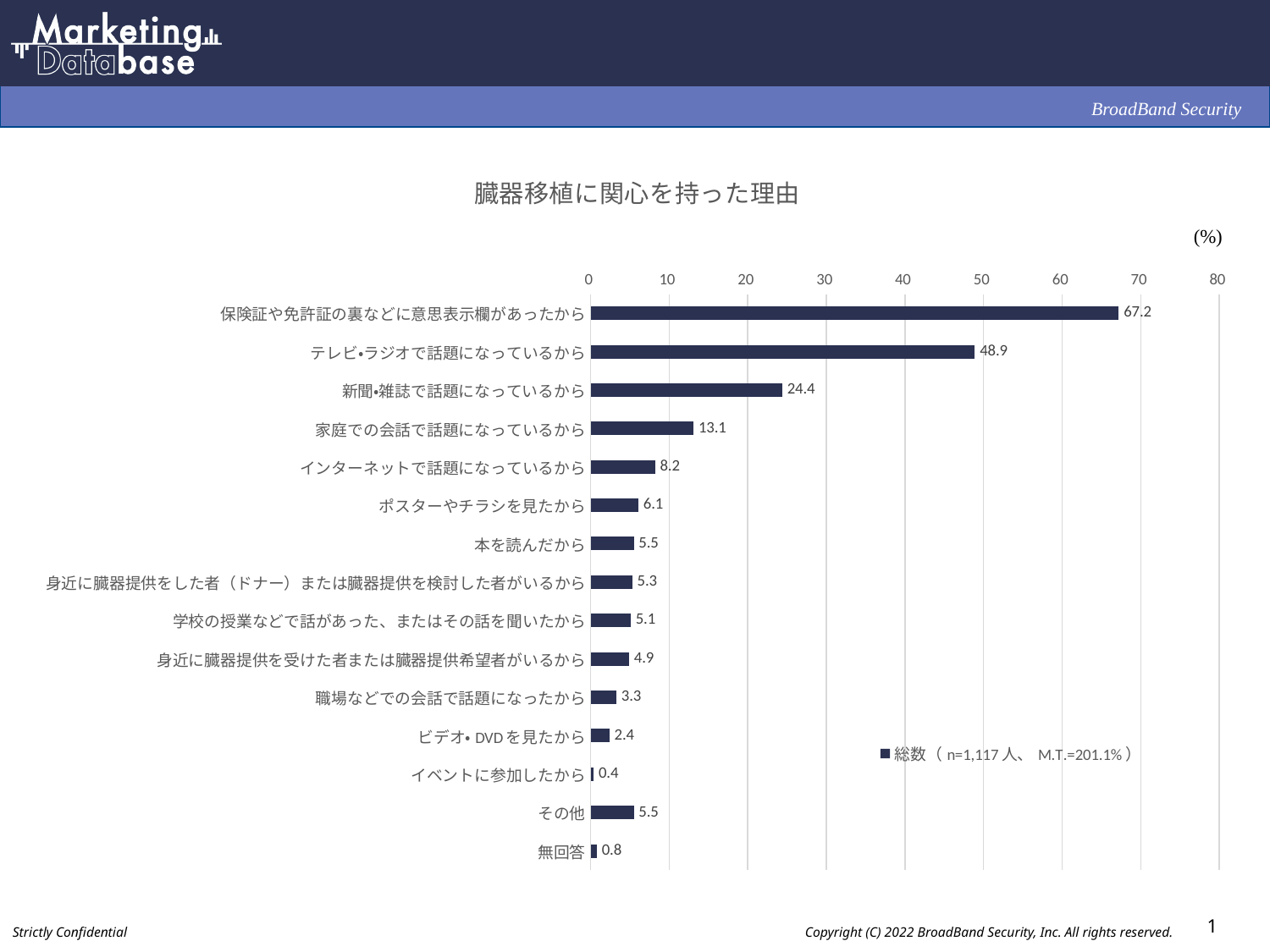
How many series does the legend list? 1 Which is larger, the value for 新聞•雑誌で話題になっているから or the value for 家庭での会話で話題になっているから? 新聞•雑誌で話題になっているから What is the value for 家庭での会話で話題になっているから? 13.1 What is the difference between the values for 保険証や免許証の裏などに意思表示欄があったから and テレビ•ラジオで話題になっているから? 18.3 What is the value for テレビ•ラジオで話題になっているから? 48.9 Which category has the lowest value? イベントに参加したから Is the value for テレビ•ラジオで話題になっているから greater or less than 40? greater Which category has the highest value? 保険証や免許証の裏などに意思表示欄があったから What is the value for 保険証や免許証の裏などに意思表示欄があったから? 67.2 What is the title of the chart? 臓器移植に関心を持った理由 How many categories are shown in the chart? 15 What kind of chart is shown on the slide? Bar chart